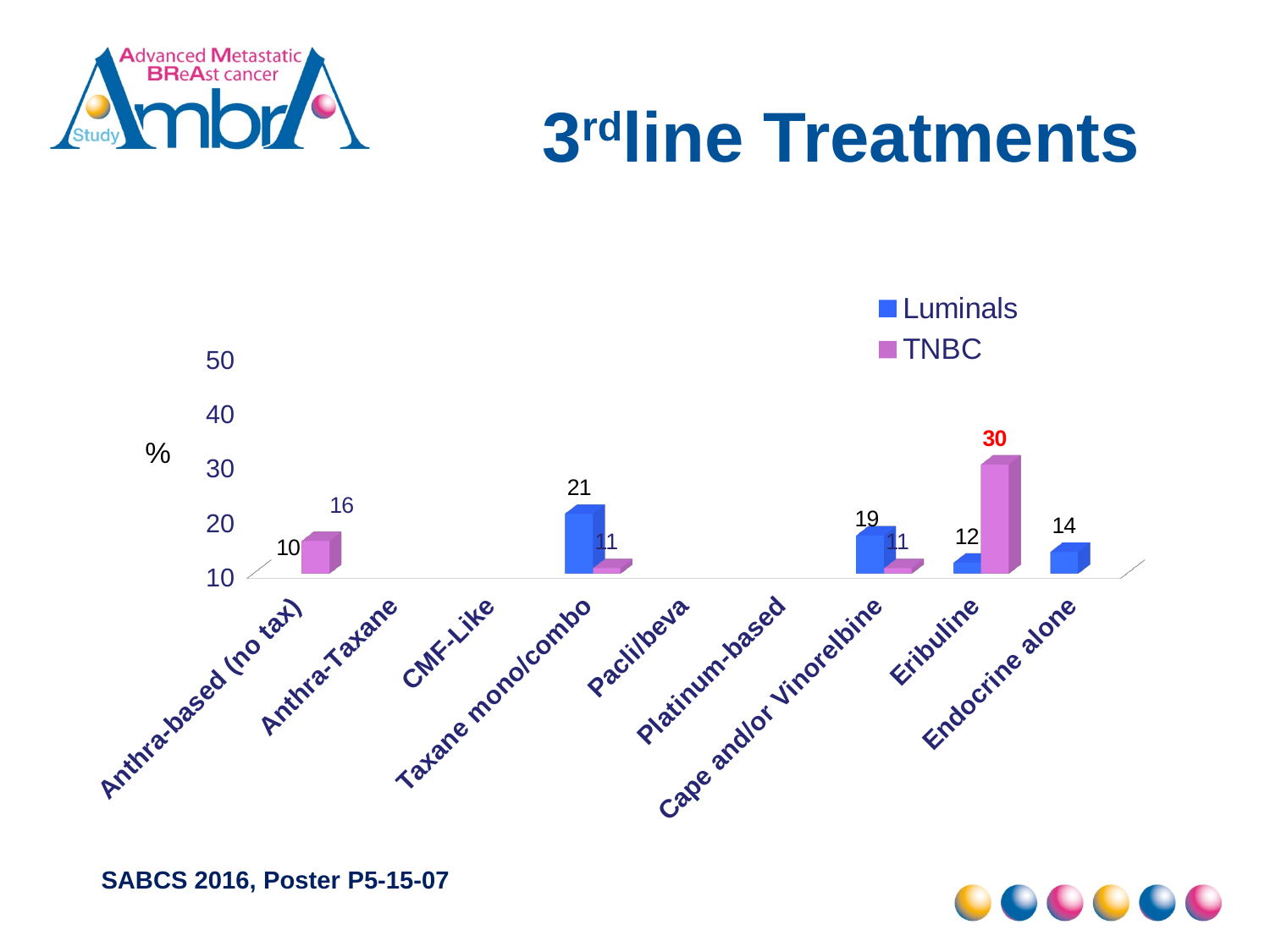
What is the Luminals value for Endocrine alone? 14 What is the Luminals value for Cape and/or Vinorelbine? 19 What is the difference between the TNBC and Luminals values for Eribuline? 18 What is the TNBC value for Eribuline? 30 What kind of chart is shown on the slide? bar chart What is the Luminals value for Taxane mono/combo? 21 Which treatment has the highest TNBC value? Eribuline For Taxane mono/combo, which series has the larger value, Luminals or TNBC? Luminals How many treatment categories are shown on the x axis? 9 How many series does the legend list? 2 What is the TNBC value for Anthra-based (no tax)? 16 What is the title of the chart on the slide? 3rd line Treatments